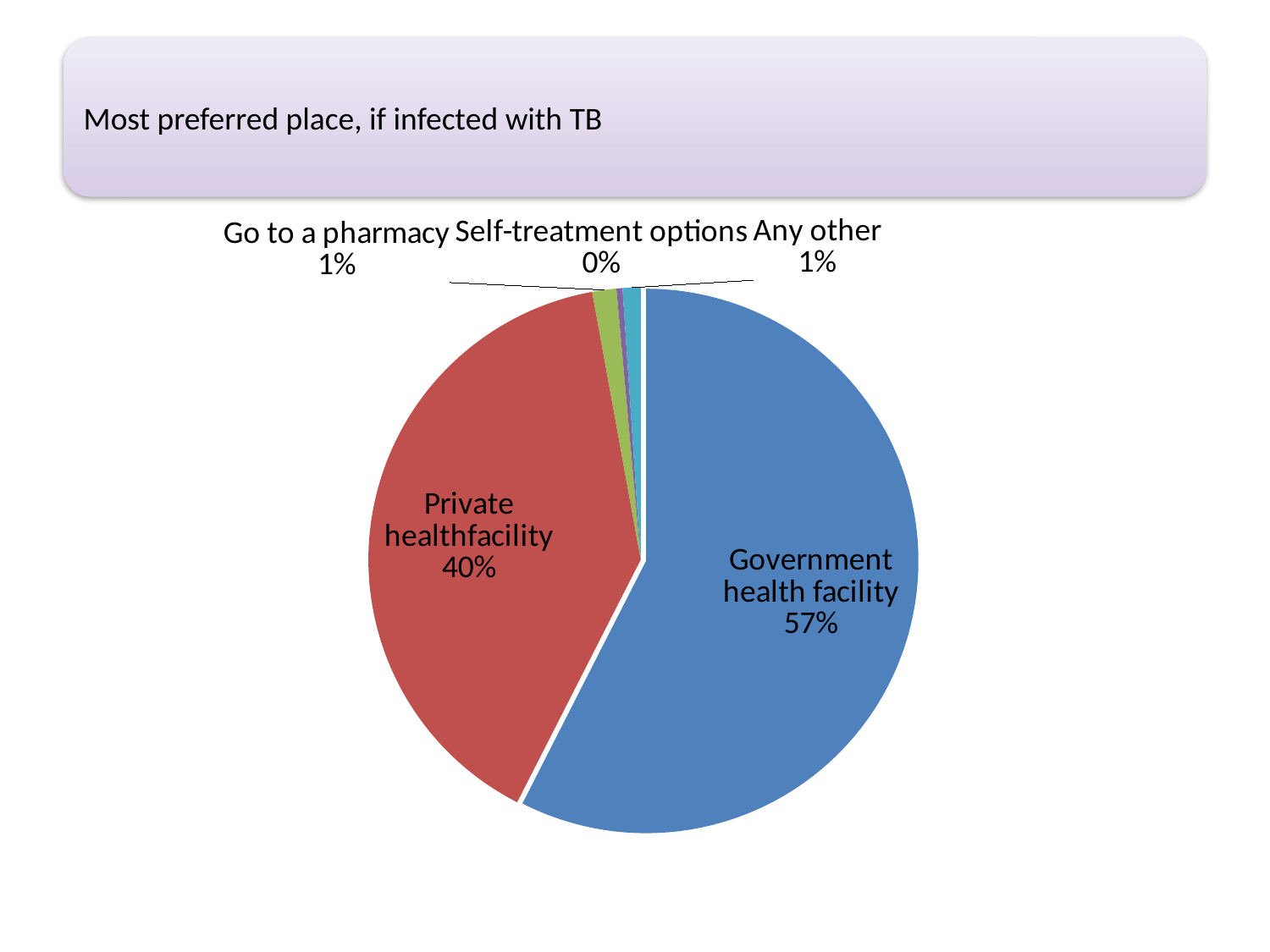
What share of the pie is Private healthfacility? 40% What share of the pie is Go to a pharmacy? 1% What is the difference in percentage points between Government health facility and Private healthfacility? 17 What share of the pie is Any other? 1% What share of the pie is Government health facility? 57% How many categories are shown in the pie chart? 5 Which is larger, Government health facility or Private healthfacility? Government health facility What is the title shown above the chart? Most preferred place, if infected with TB Which category has the smallest slice of the pie? Self-treatment options What kind of chart is shown on the slide? Pie chart Which category has the largest slice of the pie? Government health facility What share of the pie is Self-treatment options? 0%